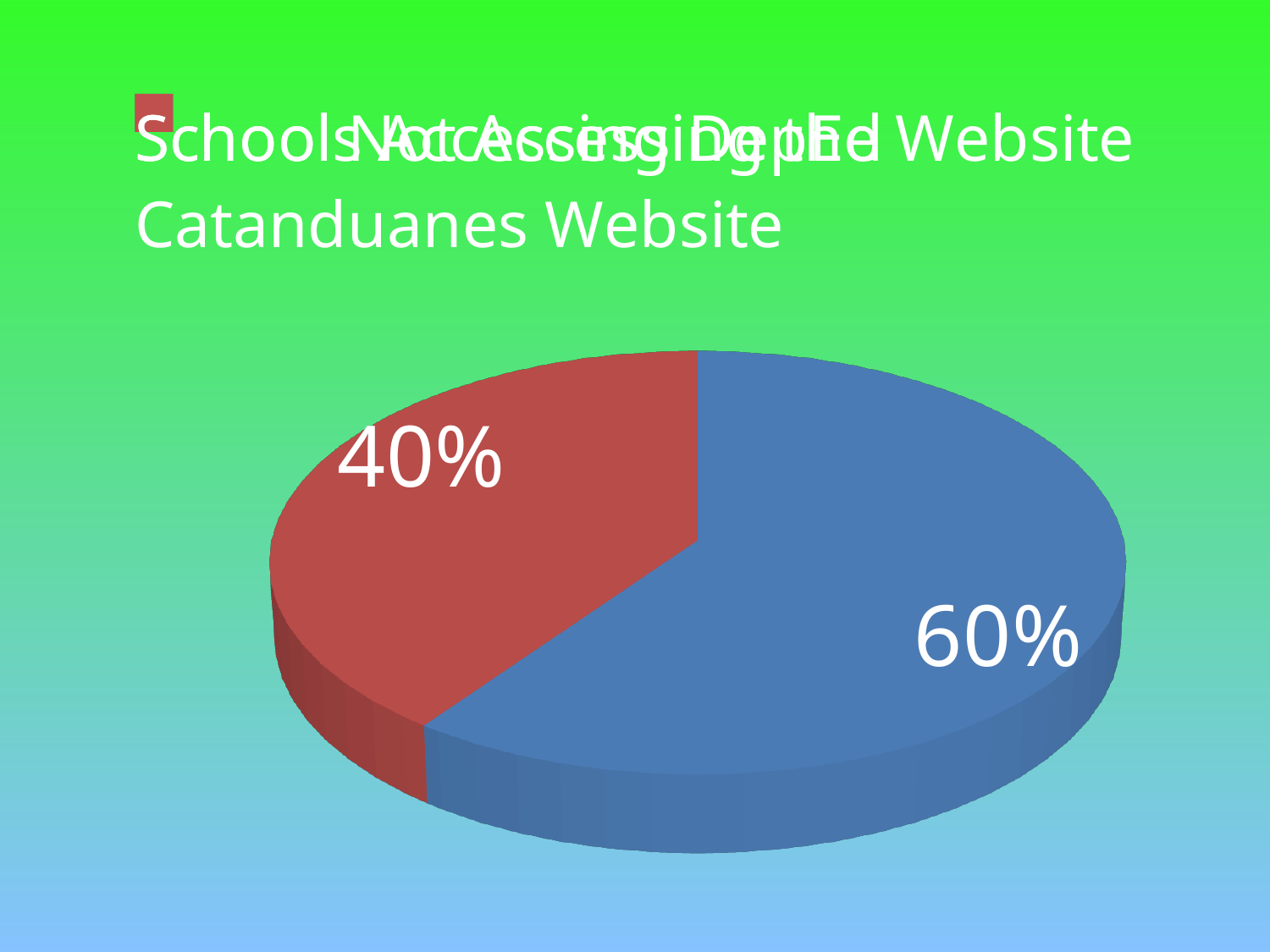
What do the two slice percentages in the pie chart add up to? 100% By how many percentage points does the blue slice exceed the red slice? 20 percentage points What two colours are used for the slices of the pie chart? Blue and red Which slice of the pie chart is the smallest? The red slice (40%) How many slices does the pie chart have? 2 What percentage is shown on the blue slice of the pie chart? 60% Which slice is larger, the blue slice or the red slice? The blue slice Which slice of the pie chart is the largest? The blue slice (60%) What kind of chart is shown on the slide? Pie chart What share of the pie does the red slice represent? 40% Is the pie chart drawn in 3D or flat 2D style? 3D What percentage is shown on the red slice of the pie chart? 40%